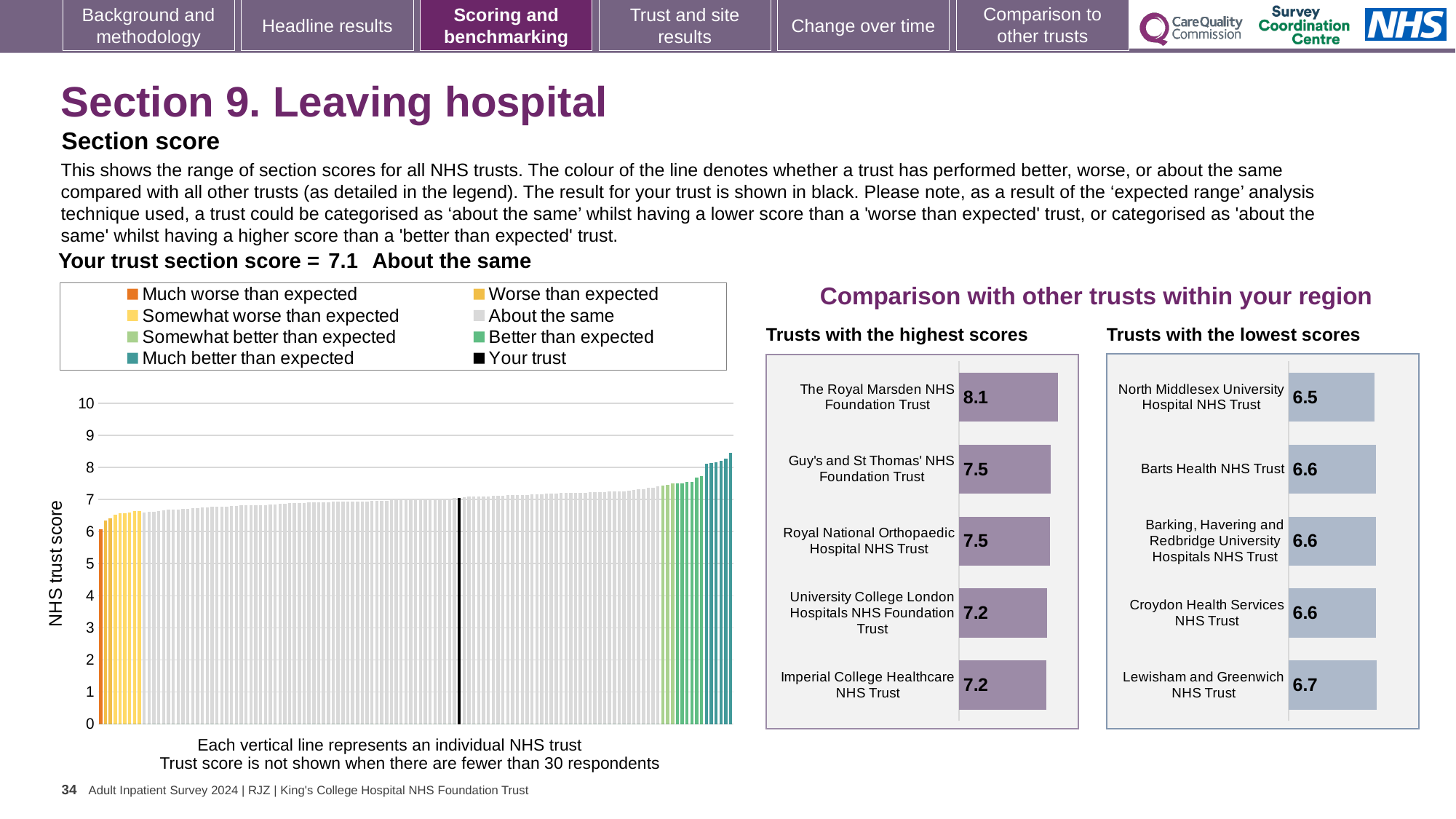
In the 'Trusts with the lowest scores' chart, which has the larger score: Barts Health NHS Trust or Lewisham and Greenwich NHS Trust? Lewisham and Greenwich NHS Trust In the 'Trusts with the highest scores' chart, what is the difference between the scores of The Royal Marsden NHS Foundation Trust and Guy's and St Thomas' NHS Foundation Trust? 0.6 In the 'Trusts with the highest scores' chart, what is the score for Imperial College Healthcare NHS Trust? 7.2 In the 'Trusts with the lowest scores' chart, which trust has the lowest score? North Middlesex University Hospital NHS Trust How many trusts are shown in the 'Trusts with the highest scores' chart? 5 In the 'Trusts with the lowest scores' chart, what is the score for Lewisham and Greenwich NHS Trust? 6.7 How many entries does the legend of the main chart on the left list? 8 In the main chart of NHS trust scores on the left, what is the section score for your trust? 7.1 In the main chart of NHS trust scores on the left, is the value of the rightmost bar greater or less than 8? greater In the 'Trusts with the highest scores' chart, which trust has the highest score? The Royal Marsden NHS Foundation Trust In the 'Trusts with the lowest scores' chart, what is the score for North Middlesex University Hospital NHS Trust? 6.5 In the 'Trusts with the highest scores' chart, what is the score for The Royal Marsden NHS Foundation Trust? 8.1